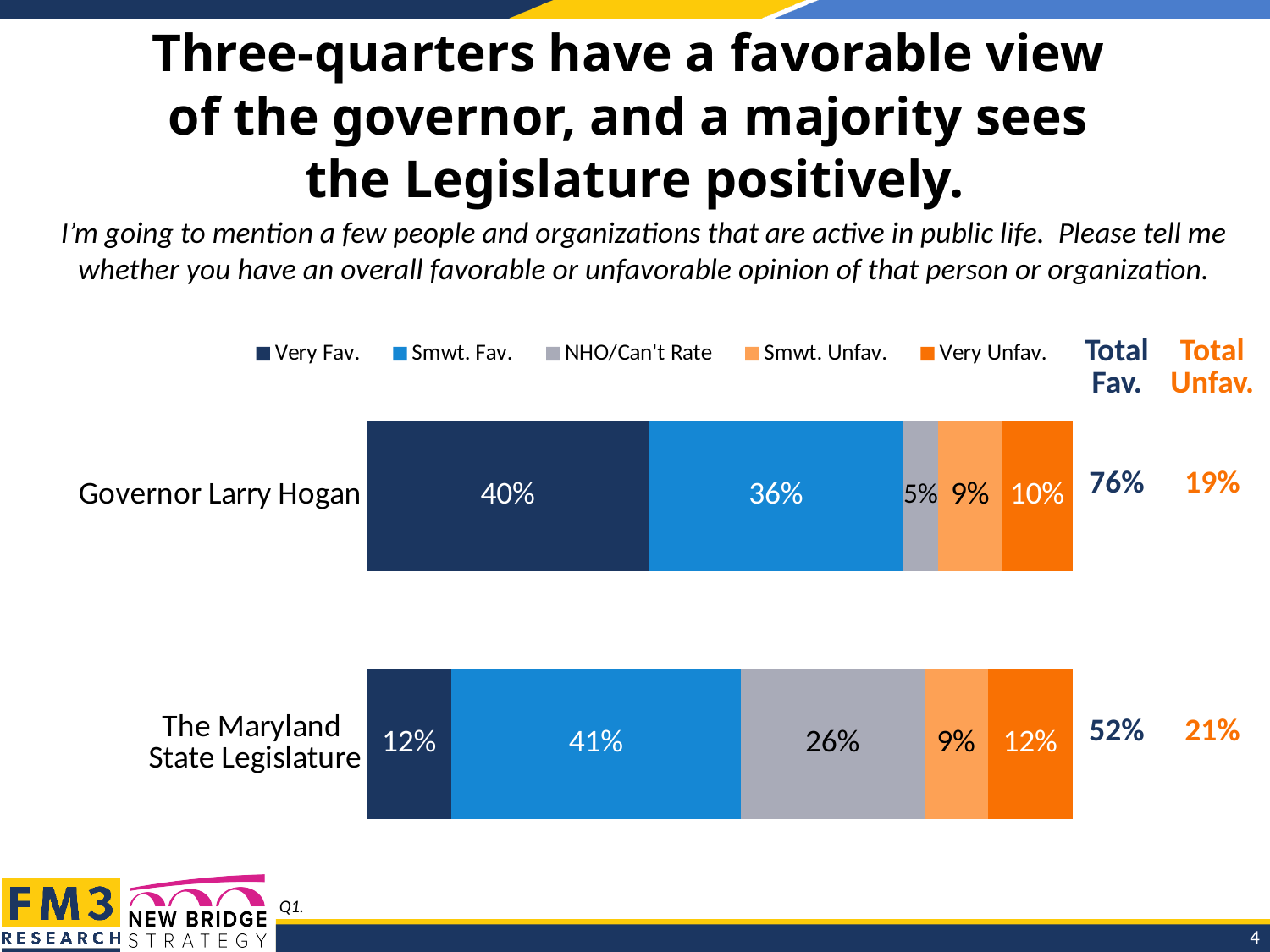
What kind of chart is shown on the slide? Stacked bar chart What is the Smwt. Fav. value for The Maryland State Legislature? 41% What is the NHO/Can't Rate value for The Maryland State Legislature? 26% What percentage of respondents have a Very Fav. opinion of Governor Larry Hogan? 40% How many series does the legend list? 5 What is the difference between the Total Fav. figures for Governor Larry Hogan and The Maryland State Legislature? 24% What is the Very Unfav. value for Governor Larry Hogan? 10% How many categories are plotted on the chart? 2 What is the Total Fav. figure shown for Governor Larry Hogan? 76% What is the difference between the Very Fav. values for Governor Larry Hogan and The Maryland State Legislature? 28% What is the Total Unfav. figure shown for The Maryland State Legislature? 21% Which category has the higher Very Fav. value, Governor Larry Hogan or The Maryland State Legislature? Governor Larry Hogan